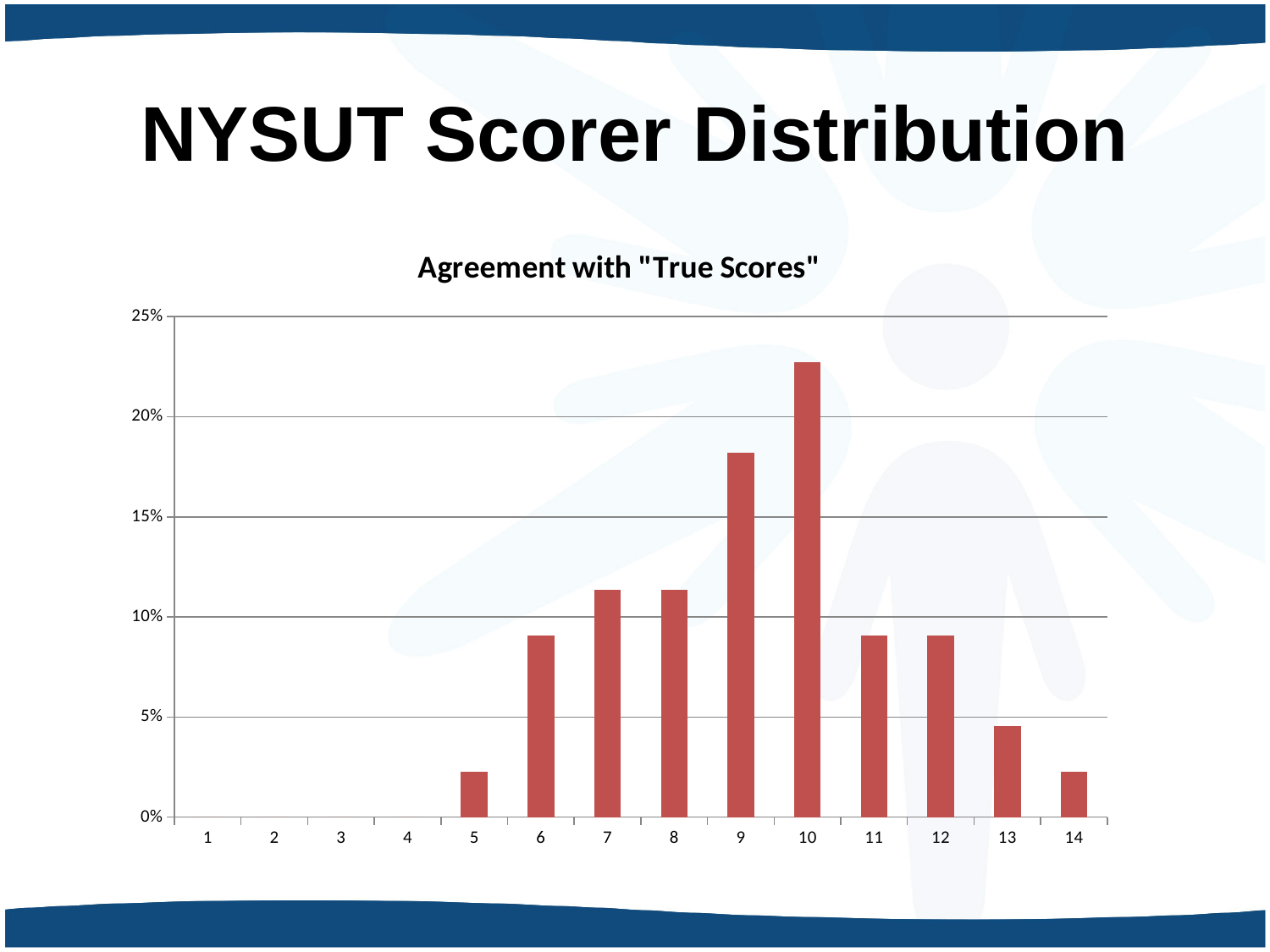
What is the title of the chart? Agreement with "True Scores" Is the value for category 7 greater or less than 10%? greater Is the value for category 6 greater or less than 10%? less Which category has the highest bar in the chart? 10 Which is larger, the value for category 9 or the value for category 10? 10 Is the value for category 10 greater or less than 20%? greater What kind of chart is shown on the slide? bar chart Which is larger, the value for category 11 or the value for category 13? 11 How many categories are shown on the x axis of the chart? 14 What is the value shown for category 1? 0%